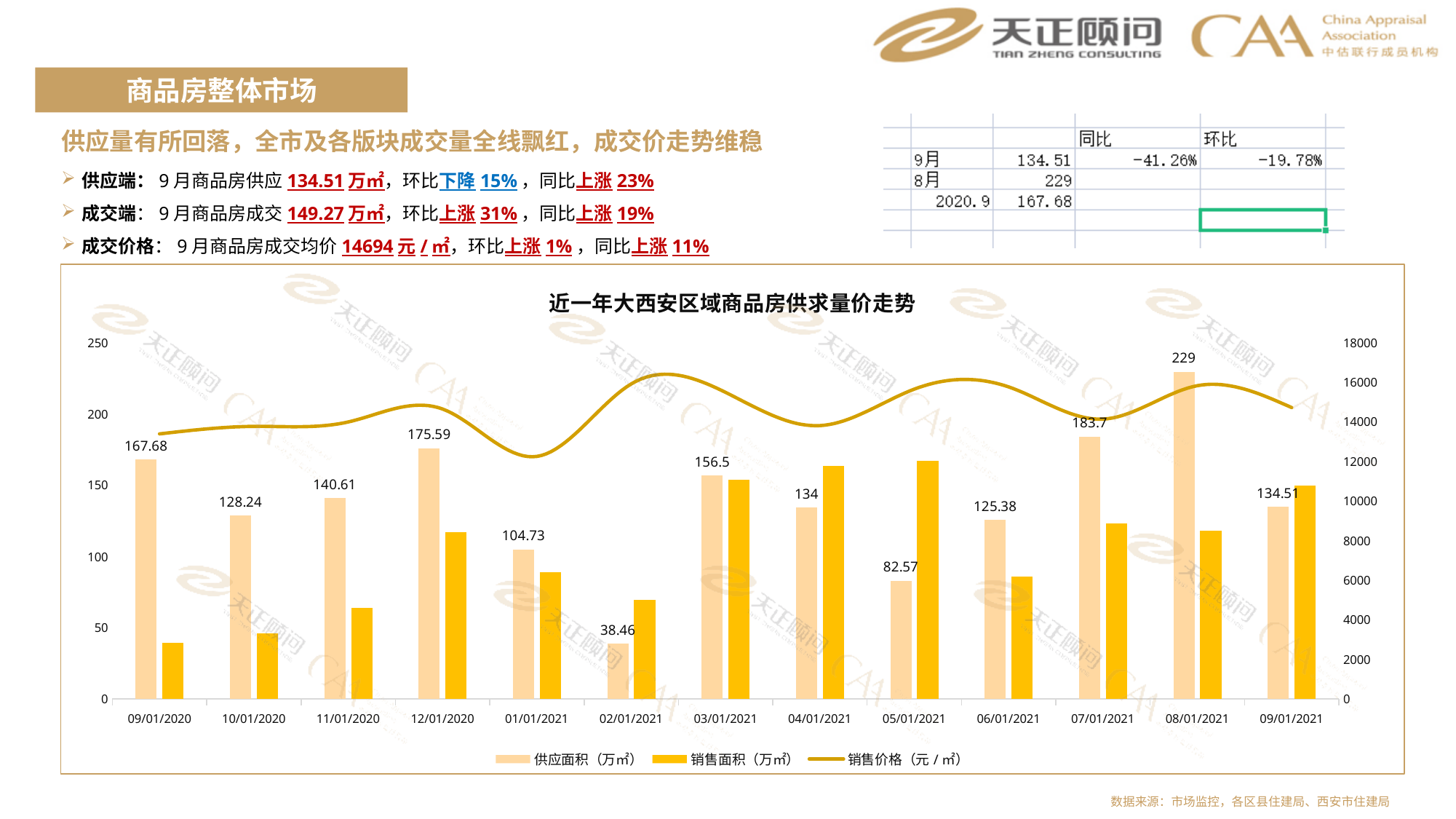
What is the difference between the 供应面积（万㎡） values for 08/01/2021 and 02/01/2021? 190.54 Is the 销售面积（万㎡） value for 09/01/2021 greater or less than 100? greater What is the title of the chart? 近一年大西安区域商品房供求量价走势 Which month has the lowest 供应面积（万㎡） value? 02/01/2021 How many months are shown on the x axis of the chart? 13 How many series does the chart legend list? 3 What is the difference between the 供应面积（万㎡） values for 07/01/2021 and 06/01/2021? 58.32 What is the 供应面积（万㎡） value for 09/01/2020? 167.68 Which month has the highest 供应面积（万㎡） value? 08/01/2021 Is the 销售面积（万㎡） value for 09/01/2020 greater or less than 50? less Which has the larger 供应面积（万㎡） value, 12/01/2020 or 11/01/2020? 12/01/2020 What is the 供应面积（万㎡） value for 08/01/2021? 229